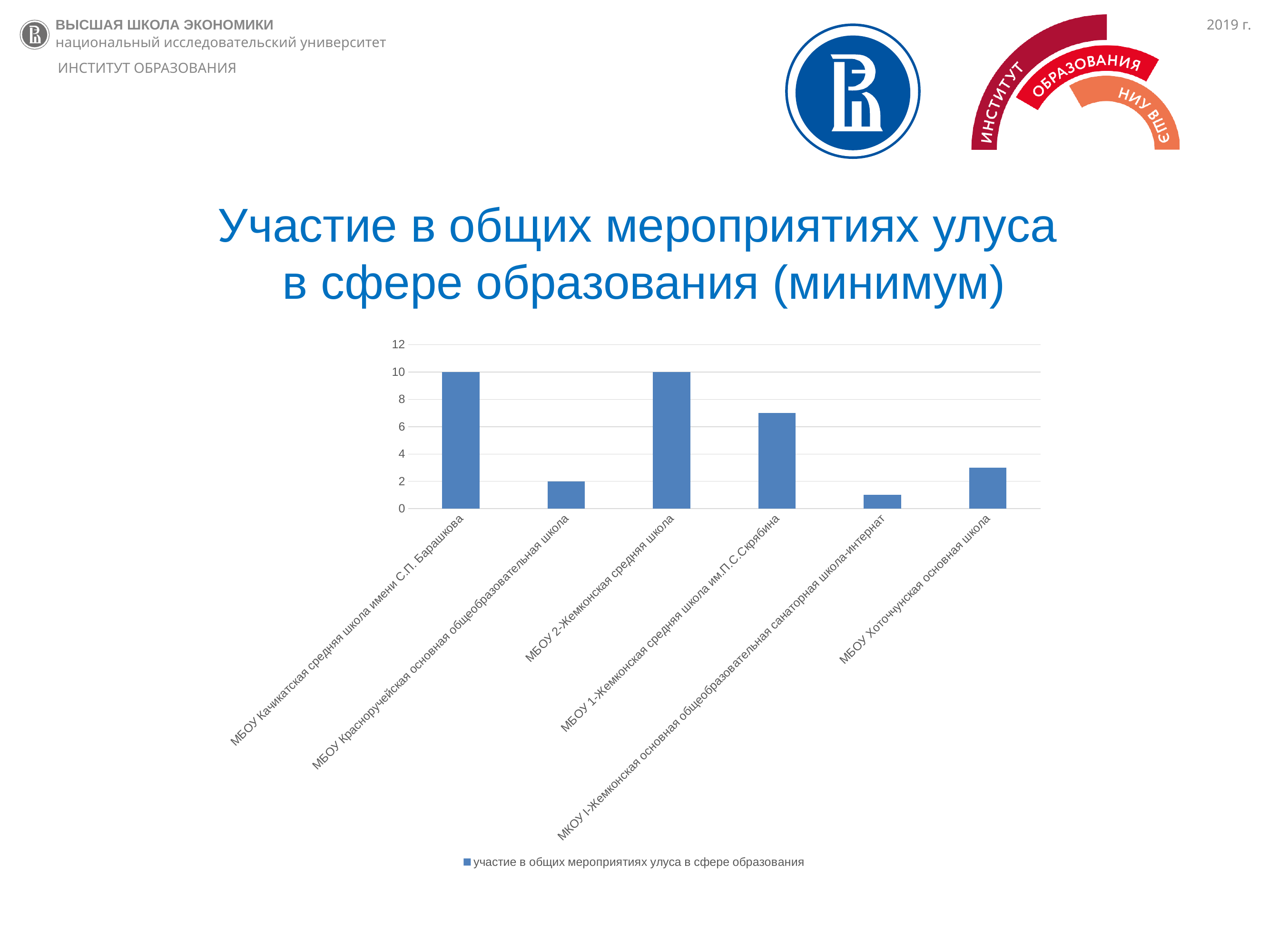
What kind of chart is shown on the slide? bar chart What is the difference between the values for МБОУ Качикатская средняя школа имени С.П. Барашкова and МБОУ Красноручейская основная общеобразовательная школа? 8 Is the value for МБОУ Хоточчунская основная школа greater or less than 4? less What is the value for МБОУ 2-Жемконская средняя школа? 10 What is the legend entry of the series shown in the chart? участие в общих мероприятиях улуса в сфере образования Which has a larger value: МБОУ 1-Жемконская средняя школа им.П.С.Скрябина or МБОУ Хоточчунская основная школа? МБОУ 1-Жемконская средняя школа им.П.С.Скрябина What is the value for МБОУ Красноручейская основная общеобразовательная школа? 2 Is the value for МБОУ 1-Жемконская средняя школа им.П.С.Скрябина greater or less than 6? greater How many schools (categories) are shown on the x axis of the chart? 6 What is the value for МБОУ Качикатская средняя школа имени С.П. Барашкова? 10 Which school has the lowest value in the chart? МКОУ I-Жемконская основная общеобразовательная санаторная школа-интернат How many series does the chart legend list? 1